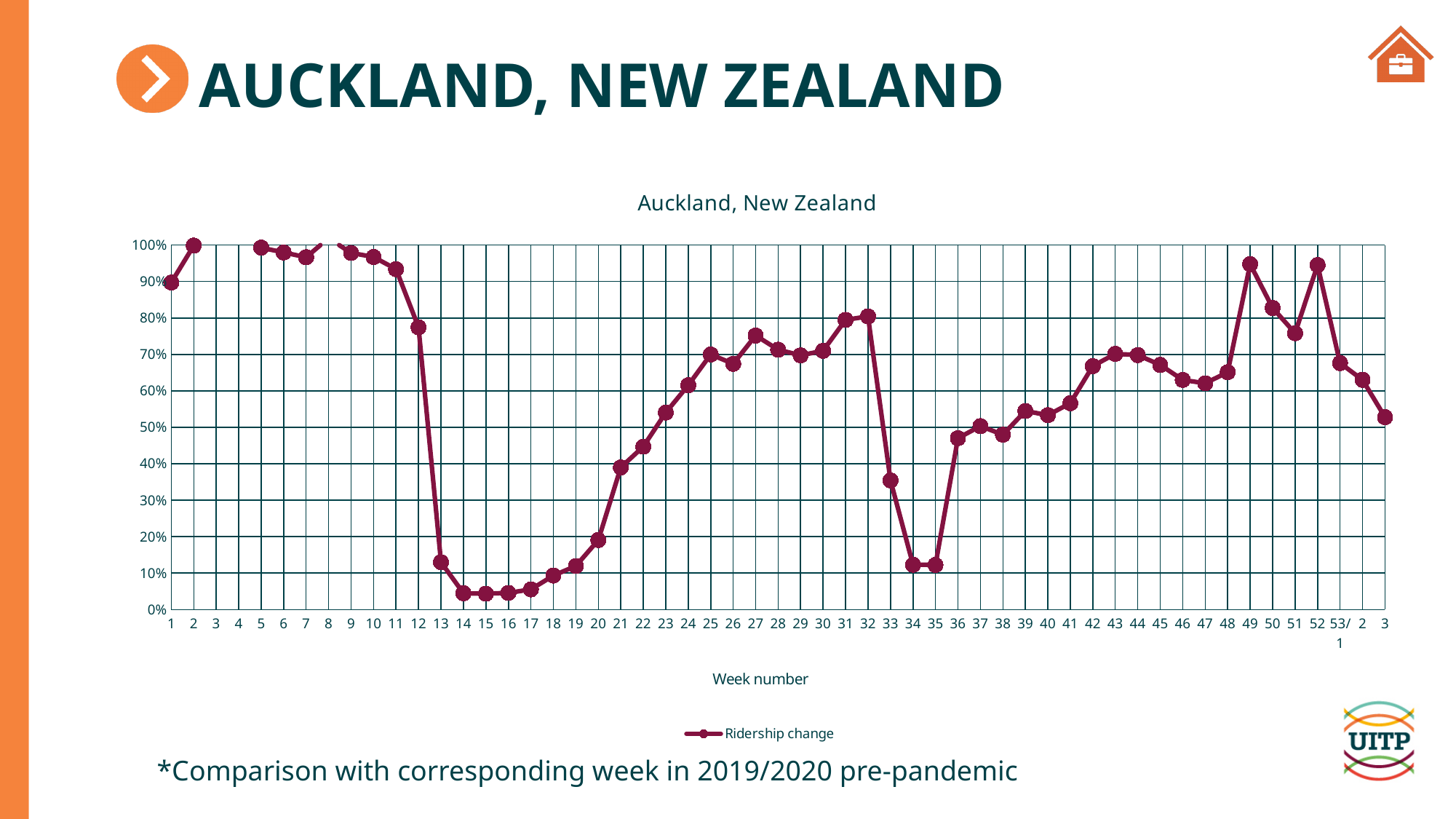
Is the value for week 49 greater or less than 90%? greater Is the value for week 12 greater or less than 70%? greater How many series does the legend list? 1 Is the value for week 14 greater or less than 10%? less Do the values rise or fall from week 14 to week 27? rise What kind of chart is shown on the slide? line chart Which has the higher value, week 32 or week 33? week 32 What is the name of the series shown in the legend? Ridership change Which has the higher value, week 12 or week 13? week 12 What is the label of the x axis? Week number